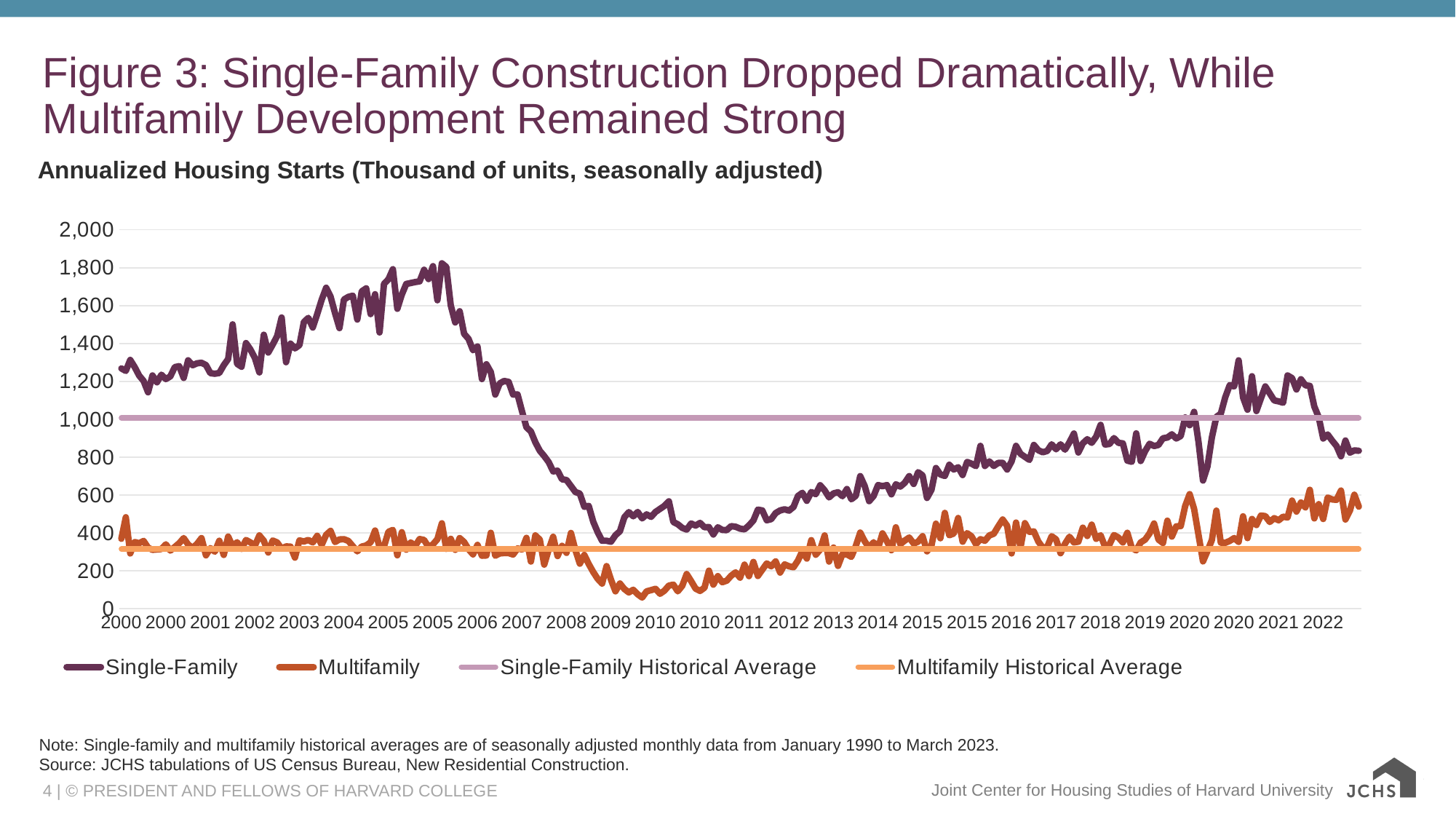
Does the Multifamily series rise or fall between 2010 and 2022? rise How many series does the legend list? 4 Does the Single-Family series rise or fall between 2005 and 2009? fall Is the Single-Family value at its peak around 2005 greater or less than 1,600? greater Which series is higher in 2005, Single-Family or Multifamily? Single-Family Is the Multifamily value at its lowest point around 2010 greater or less than 200? less Is the Multifamily value at the end of 2022 greater or less than 400? greater What unit does the chart's subtitle say the housing starts are measured in? Thousand of units, seasonally adjusted What kind of chart is shown on the slide? line chart Which of the two historical average lines is higher, Single-Family Historical Average or Multifamily Historical Average? Single-Family Historical Average